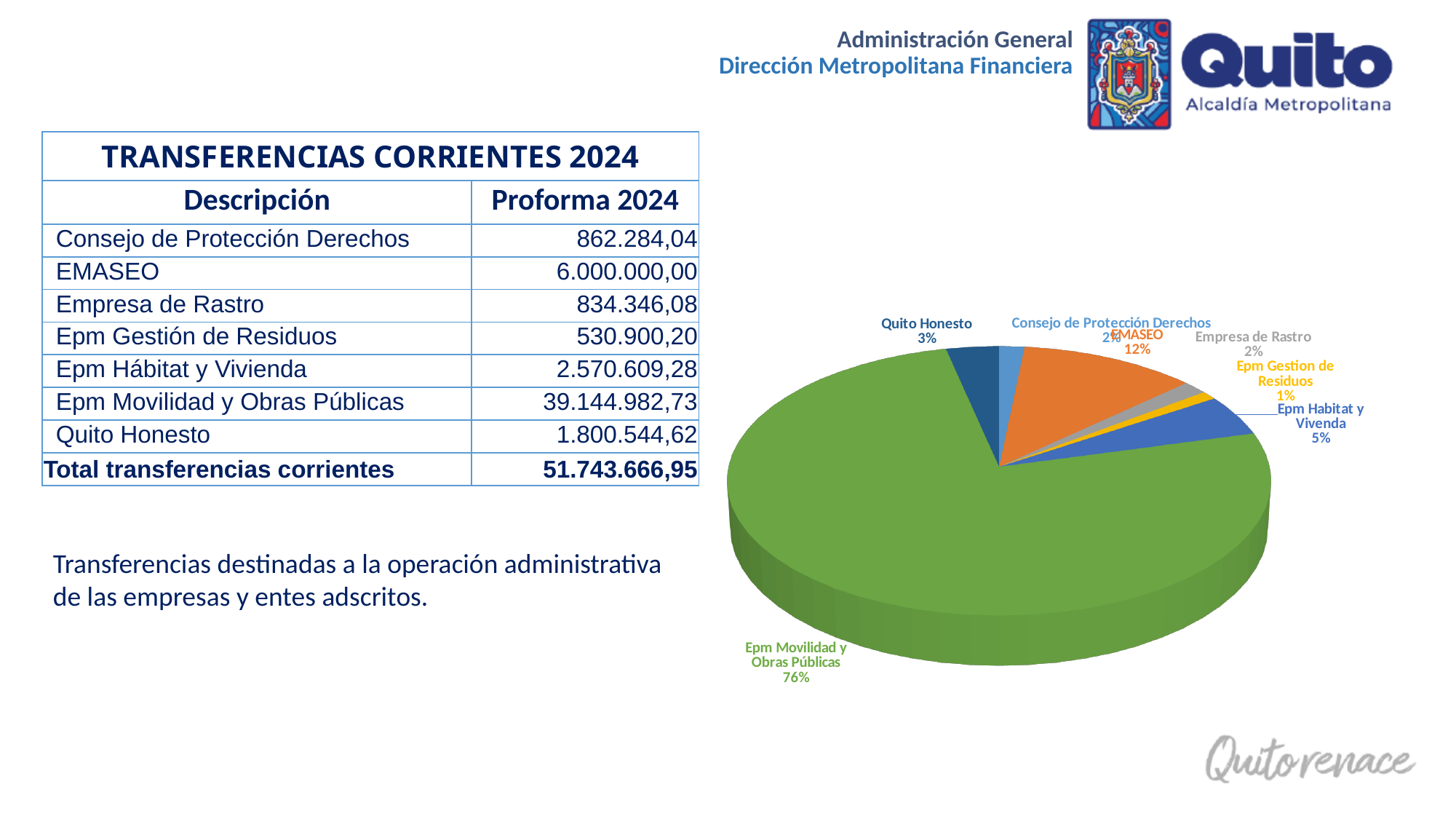
Which category has the largest slice in the pie chart? Epm Movilidad y Obras Públicas Which category has the smallest slice in the pie chart? Epm Gestion de Residuos What share of the pie does EMASEO represent? 12% What colour is the slice for Epm Movilidad y Obras Públicas in the pie chart? green What percentage is shown for Epm Habitat y Vivenda in the pie chart? 5% In the pie chart, which is larger: the slice for EMASEO or the slice for Quito Honesto? EMASEO What percentage is shown for Quito Honesto in the pie chart? 3% What kind of chart is shown on the slide? pie chart What share of the pie does Epm Movilidad y Obras Públicas represent? 76% What is the difference in percentage points between the EMASEO slice and the Epm Habitat y Vivenda slice? 7 What percentage is shown for Epm Gestion de Residuos in the pie chart? 1% How many slices does the pie chart have? 7